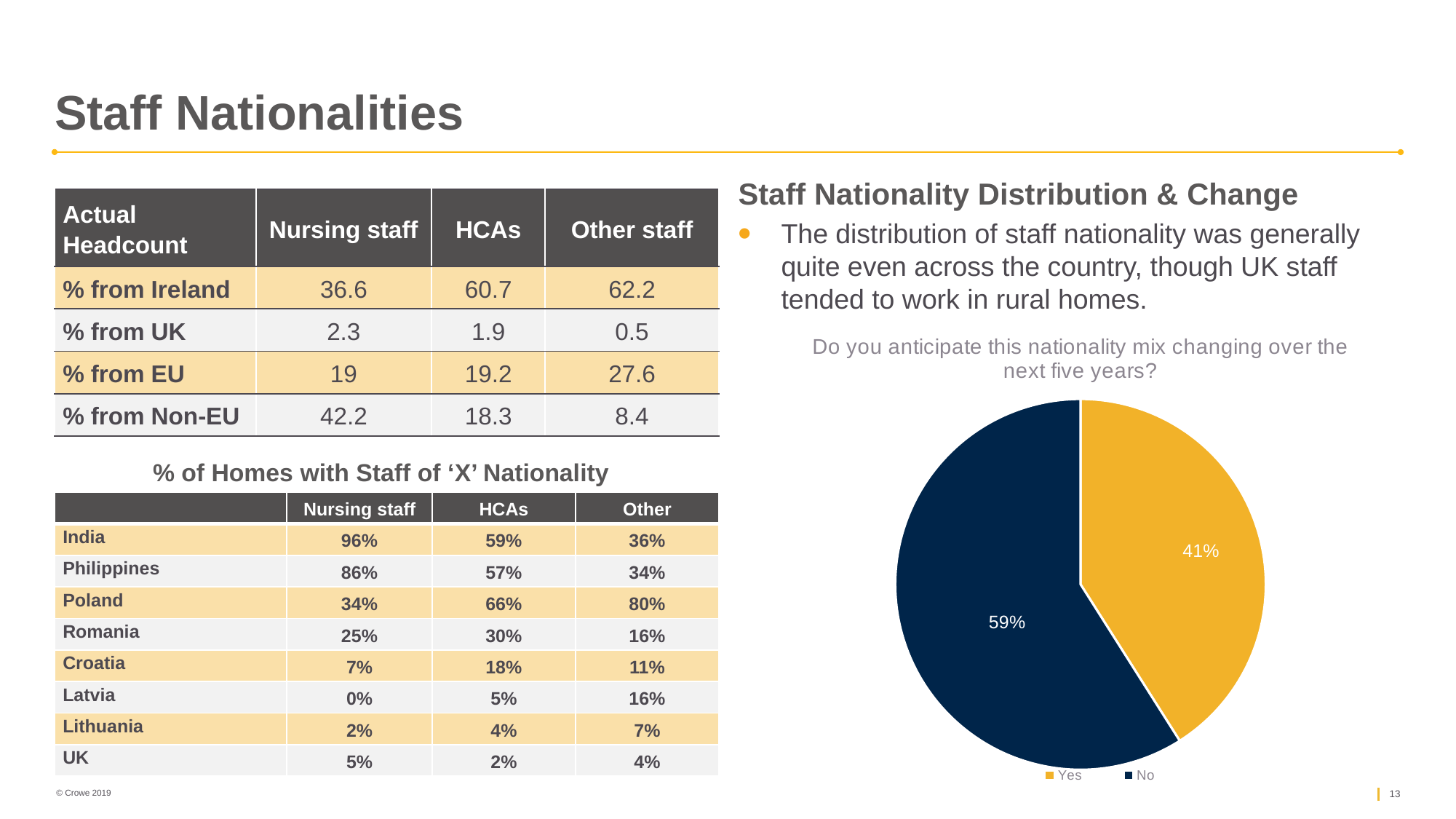
In the pie chart, what percentage of respondents answered "Yes"? 41% In the pie chart, is the "No" share larger or smaller than the "Yes" share? larger Which slice of the pie chart is the largest? No Which slice of the pie chart is the smallest? Yes What is the difference in percentage points between the "No" and "Yes" slices of the pie chart? 18 What colour is the "Yes" slice in the pie chart? yellow What question does the pie chart's title ask? Do you anticipate this nationality mix changing over the next five years? How many entries does the pie chart's legend list? 2 In the pie chart, what percentage of respondents answered "No"? 59% What kind of chart is shown on the slide? pie chart How many slices does the pie chart have? 2